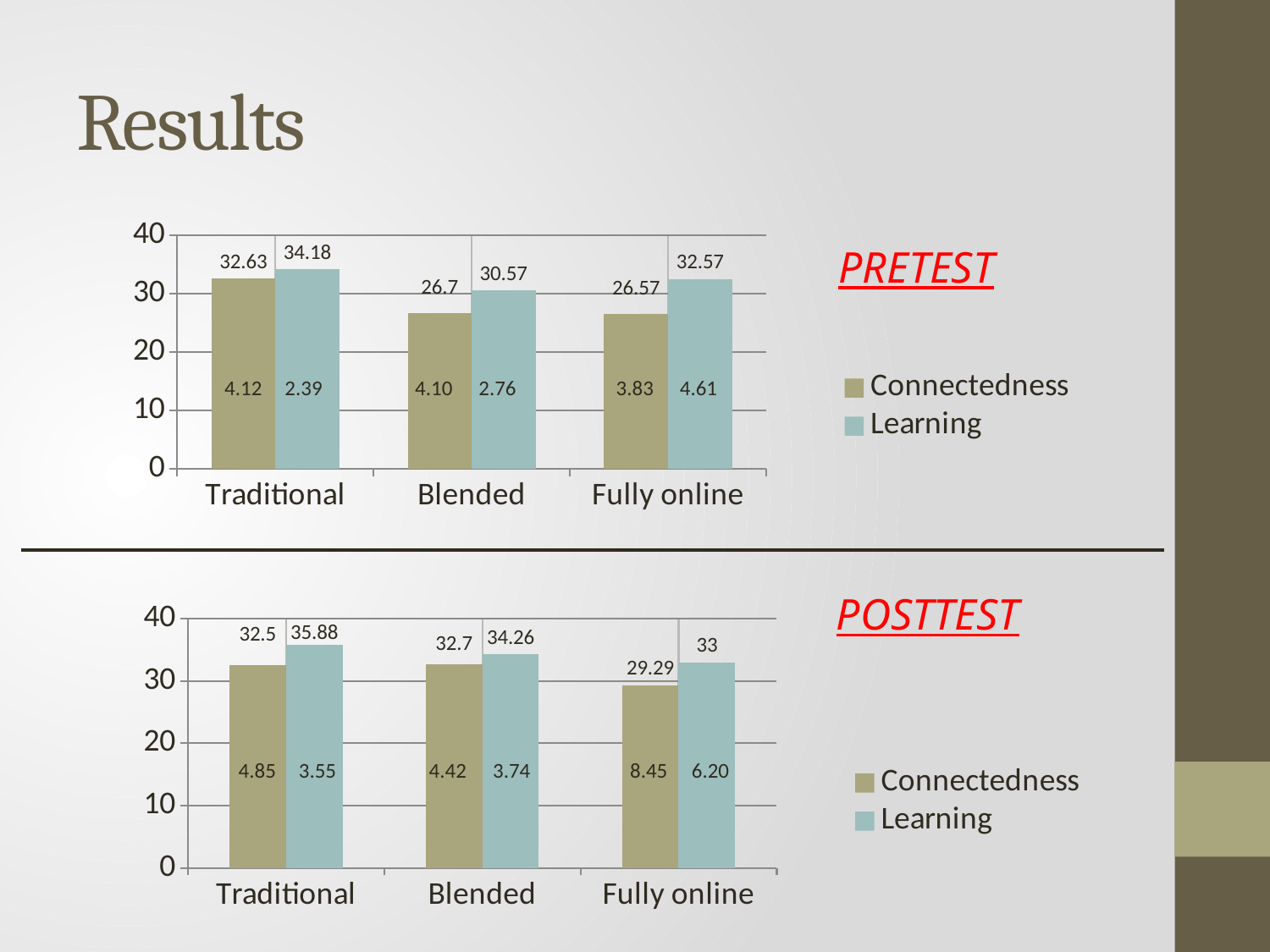
In the POSTTEST chart, what is the value of the Learning bar for Blended? 34.26 How many series does the legend of the PRETEST chart list? 2 In the PRETEST chart, which category has the highest Learning value? Traditional In the POSTTEST chart, which category has the lowest Connectedness value? Fully online In the PRETEST chart, what is the value of the Learning bar for Traditional? 34.18 In the POSTTEST chart, which is larger for Traditional: Connectedness or Learning? Learning In the POSTTEST chart, what is the value of the Connectedness bar for Fully online? 29.29 In the PRETEST chart, what is the difference between the Learning and Connectedness values for Fully online? 6 In the PRETEST chart, is the Connectedness value for Blended greater or less than 30? less In the PRETEST chart, what is the value of the Connectedness bar for Fully online? 26.57 How many categories are shown on the x axis of the POSTTEST chart? 3 What type of chart is the POSTTEST chart? Bar chart